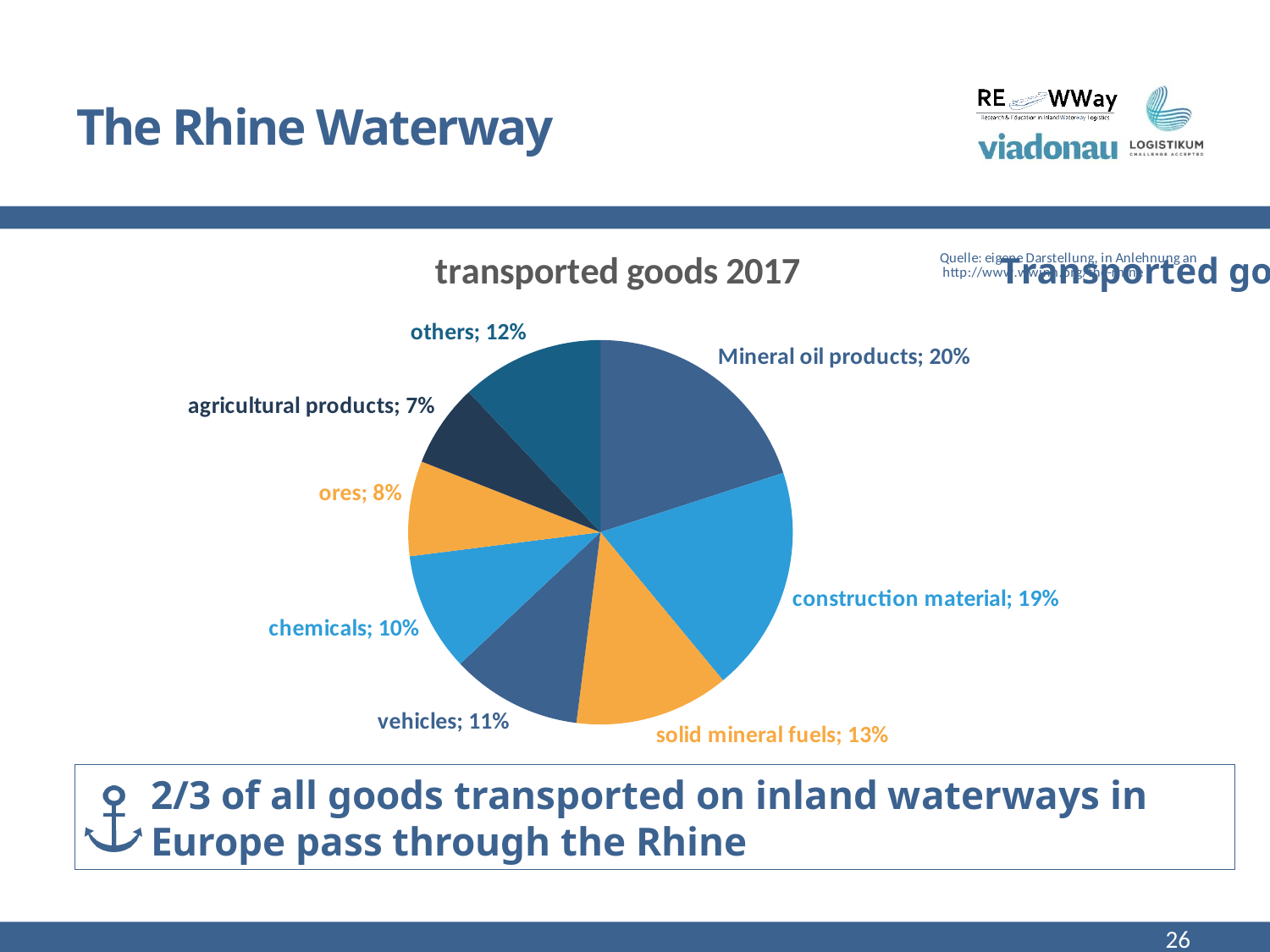
What kind of chart is shown on the slide? pie chart What share of transported goods in 2017 is Mineral oil products? 20% What share of transported goods in 2017 is construction material? 19% Which has a larger share, vehicles or ores? vehicles What is the title of the chart? transported goods 2017 Which category has the largest share of transported goods in 2017? Mineral oil products What is the difference in share between Mineral oil products and chemicals? 10% What share of transported goods in 2017 is agricultural products? 7% How many categories are shown in the pie chart? 8 What share of transported goods in 2017 is solid mineral fuels? 13% Which category has the smallest share of transported goods in 2017? agricultural products What is the combined share of ores and chemicals? 18%